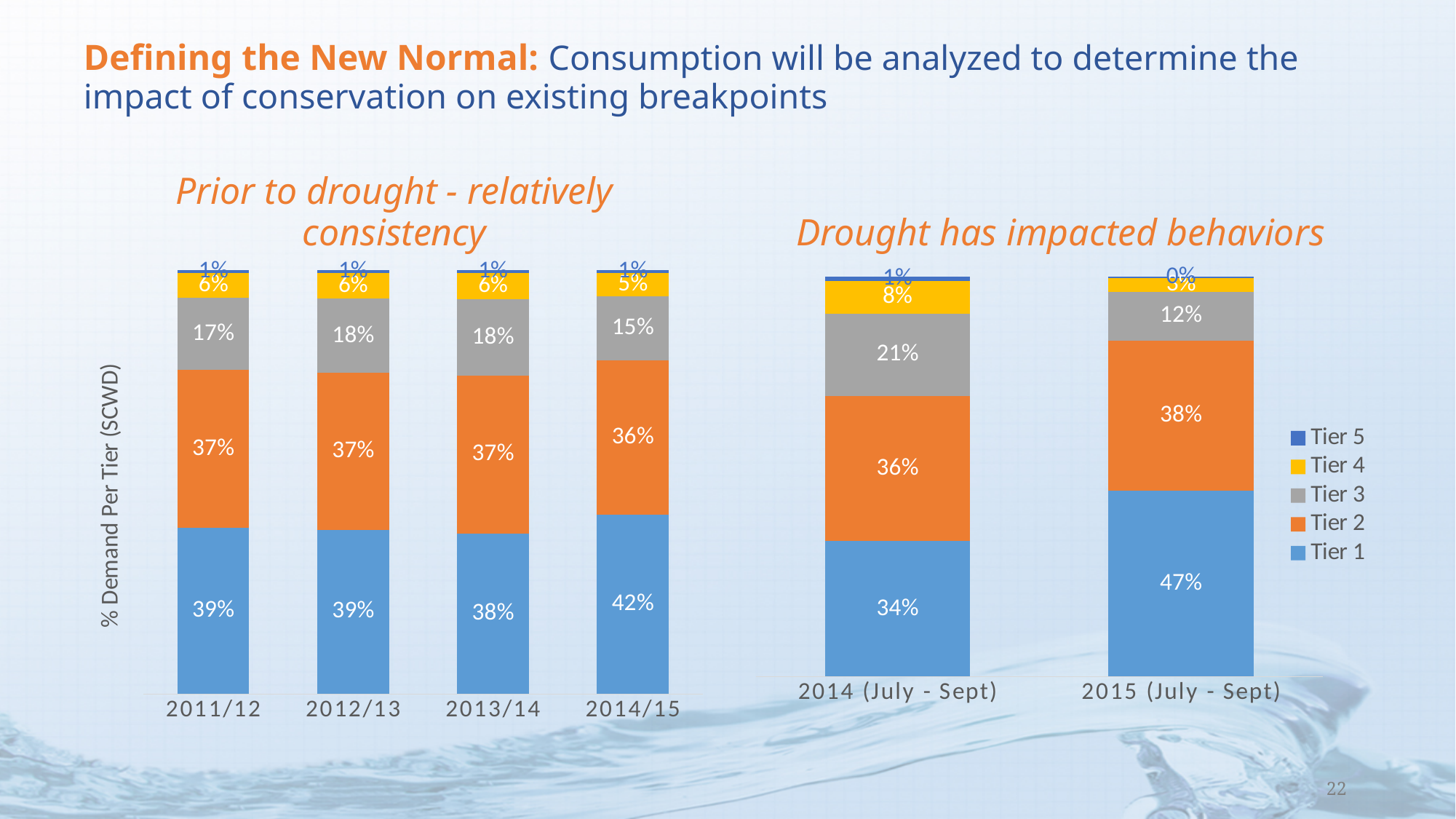
In the 'Prior to drought' chart, what is the Tier 1 value for 2014/15? 42% In the 'Prior to drought' chart, which year has the highest Tier 1 value? 2014/15 What type of chart is the 'Drought has impacted behaviors' chart? Stacked bar chart In the 'Prior to drought' chart, which year has the lowest Tier 3 value? 2014/15 In the 'Drought has impacted behaviors' chart, which is larger: Tier 3 in 2014 (July - Sept) or Tier 3 in 2015 (July - Sept)? 2014 (July - Sept) How many series does the legend list? 5 How many bars are in the 'Prior to drought' chart? 4 In the 'Drought has impacted behaviors' chart, what is the Tier 3 value for 2014 (July - Sept)? 21% In the 'Drought has impacted behaviors' chart, what is the difference in Tier 1 between 2015 (July - Sept) and 2014 (July - Sept)? 13% In the 'Prior to drought' chart, what is the Tier 2 value for 2013/14? 37% What is the y-axis label of the 'Prior to drought' chart? % Demand Per Tier (SCWD) In the 'Drought has impacted behaviors' chart, what is the Tier 1 value for 2015 (July - Sept)? 47%